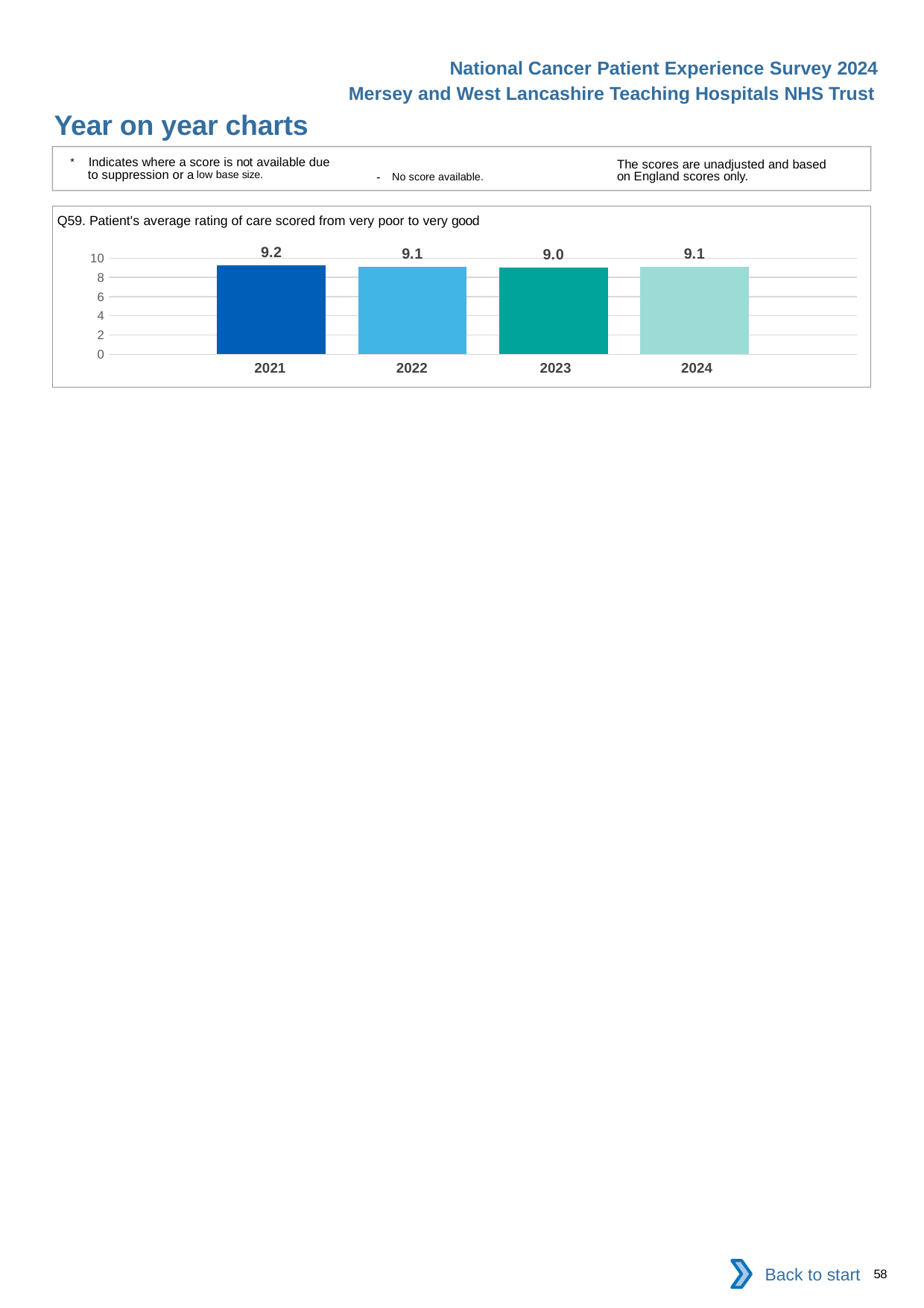
Which year has the lowest value? 2023 What is the value for 2021? 9.2 Do the values rise or fall from 2021 to 2023? fall Which is larger, the value for 2022 or the value for 2023? 2022 Which year has the highest value? 2021 What kind of chart is shown? bar chart How many years are shown on the chart? 4 What is the value for 2023? 9.0 What is the difference between the values for 2021 and 2023? 0.2 Is the value for 2024 greater or less than 8? greater What is the title of the chart? Q59. Patient's average rating of care scored from very poor to very good What is the value for 2024? 9.1